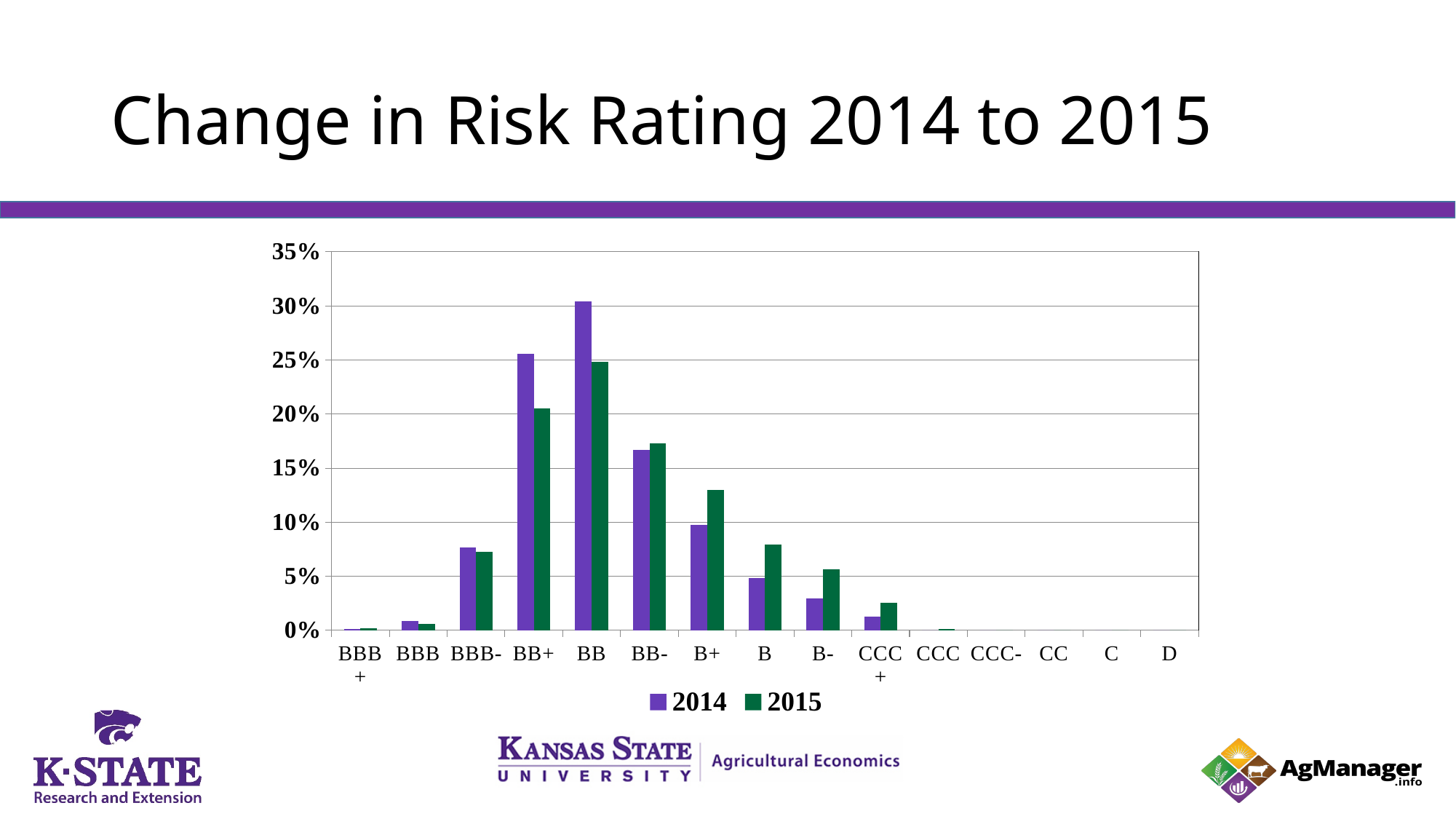
How many risk rating categories are shown on the x axis? 15 How many series does the legend list? 2 Which risk rating has the highest value for 2014? BB Is the 2014 value for BB greater or less than 25%? greater Which risk rating has the highest value for 2015? BB Is the 2015 value for B+ greater or less than 10%? greater Is the 2014 value for B- greater or less than 5%? less What kind of chart is shown on the slide? bar chart What colour are the bars for the 2015 series? green For the B rating, which year has the larger value, 2014 or 2015? 2015 For the BB+ rating, which year has the larger value, 2014 or 2015? 2014